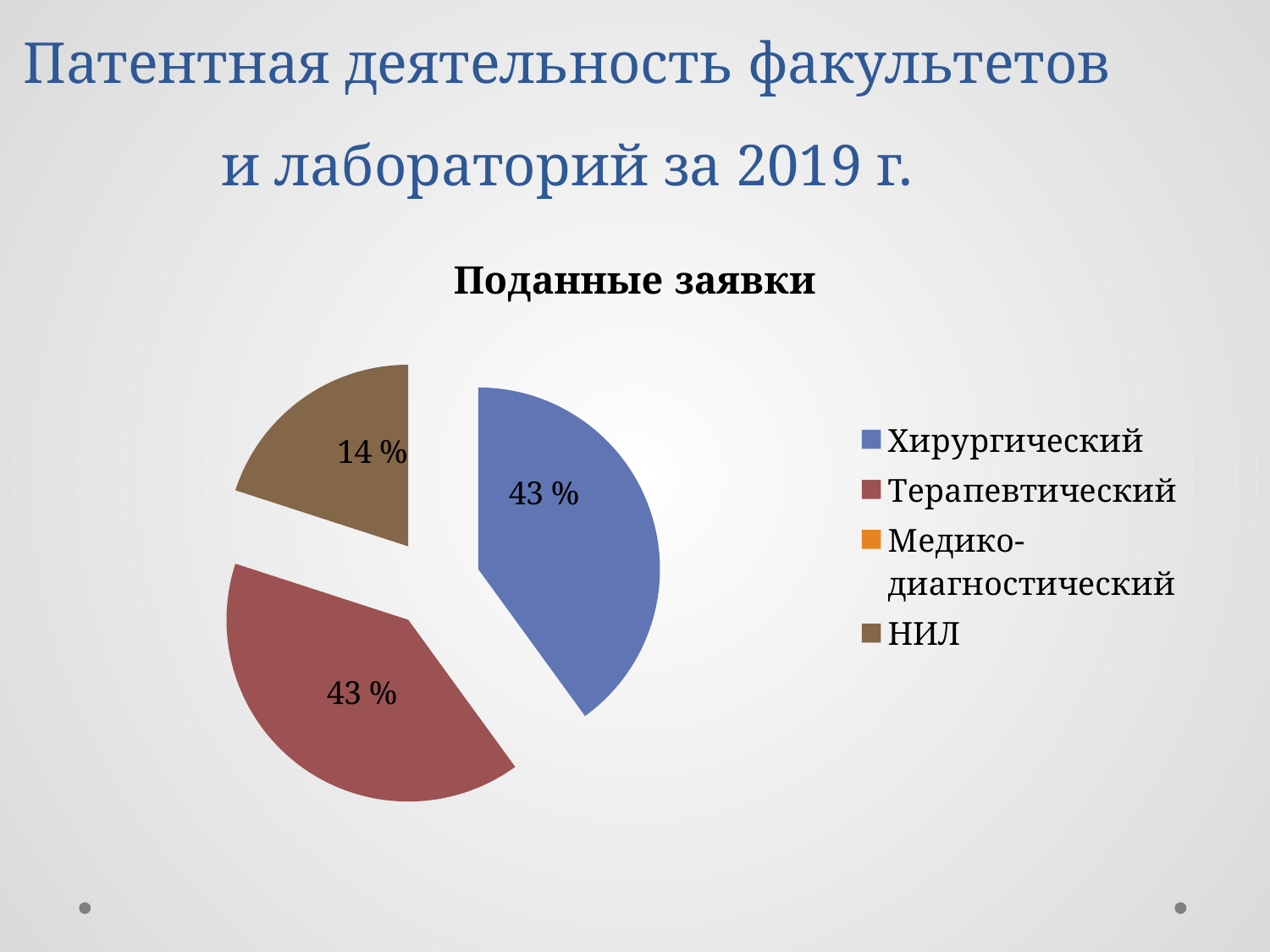
What kind of chart is shown on the slide? pie chart Which of the labelled slices has the smallest share? НИЛ How many entries does the legend list? 4 What share of the pie does Хирургический have? 43 % What is the difference between the shares of Хирургический and НИЛ? 29 % What colour is the Хирургический slice? blue What share of the pie does НИЛ have? 14 % How many slices in the pie have a percentage label? 3 What share of the pie does Терапевтический have? 43 % Which has the larger share, Терапевтический or НИЛ? Терапевтический Which has the larger share, Хирургический or НИЛ? Хирургический What is the title of the chart? Поданные заявки